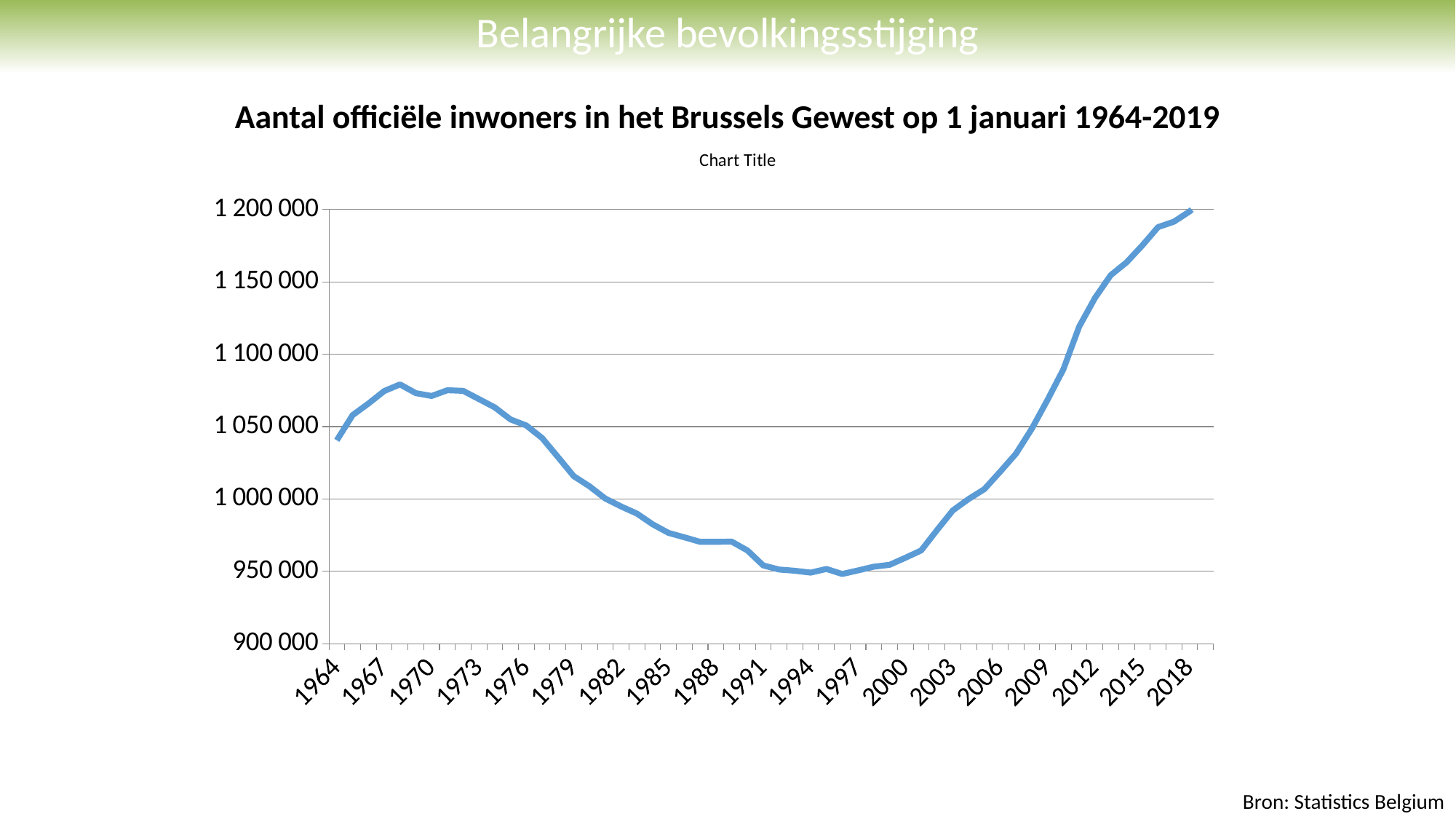
Is the value for 2012 greater or less than 1 100 000? greater Which is larger, the value for 1964 or the value for 2018? 2018 What is the bold heading printed above the chart? Aantal officiële inwoners in het Brussels Gewest op 1 januari 1964-2019 Which is larger, the value for 1970 or the value for 1991? 1970 What kind of chart is shown on the slide? line chart Is the value for 1997 greater or less than 1 000 000? less What source is credited at the bottom right of the slide? Statistics Belgium Is the value for 1964 greater or less than 1 050 000? less Do the values rise or fall along the x axis between 1973 and 1997? fall Do the values rise or fall along the x axis between 2000 and 2018? rise